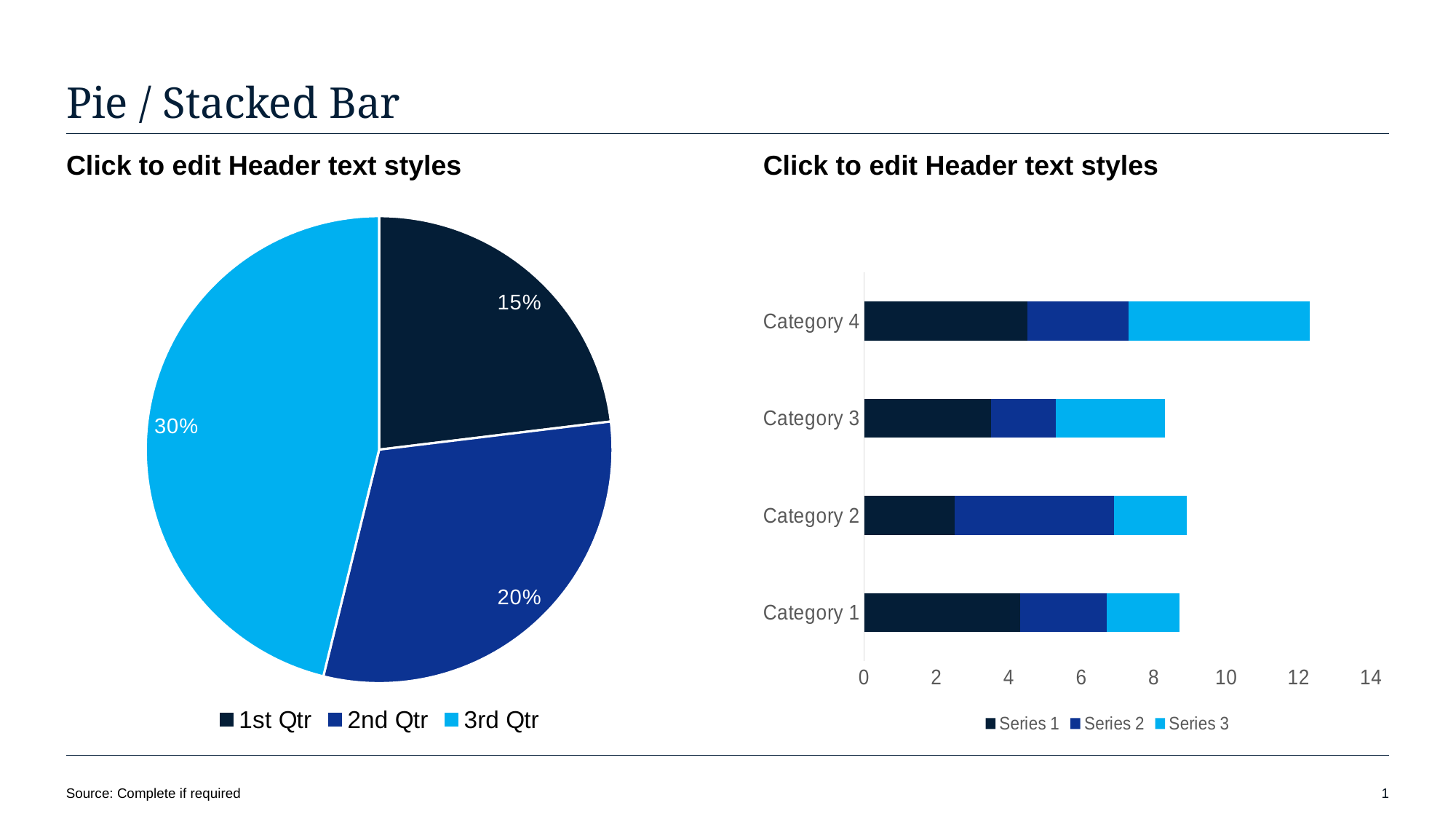
What type of chart is on the left side of the slide? Pie chart In the pie chart on the left, which slice is the largest? 3rd Qtr In the stacked bar chart on the right, is the total for Category 3 greater or less than 10? less In the pie chart on the left, how many percentage points larger is the 3rd Qtr slice than the 1st Qtr slice? 15 In the pie chart on the left, how many slices are there? 3 In the pie chart on the left, what share does 1st Qtr have? 15% In the stacked bar chart on the right, is the Series 1 value for Category 1 larger or smaller than the Series 1 value for Category 2? larger What type of chart is on the right side of the slide? Stacked bar chart In the stacked bar chart on the right, how many series does the legend list? 3 In the stacked bar chart on the right, which category has the longest total bar? Category 4 In the pie chart on the left, what share does 2nd Qtr have? 20% In the pie chart on the left, which slice is the smallest? 1st Qtr